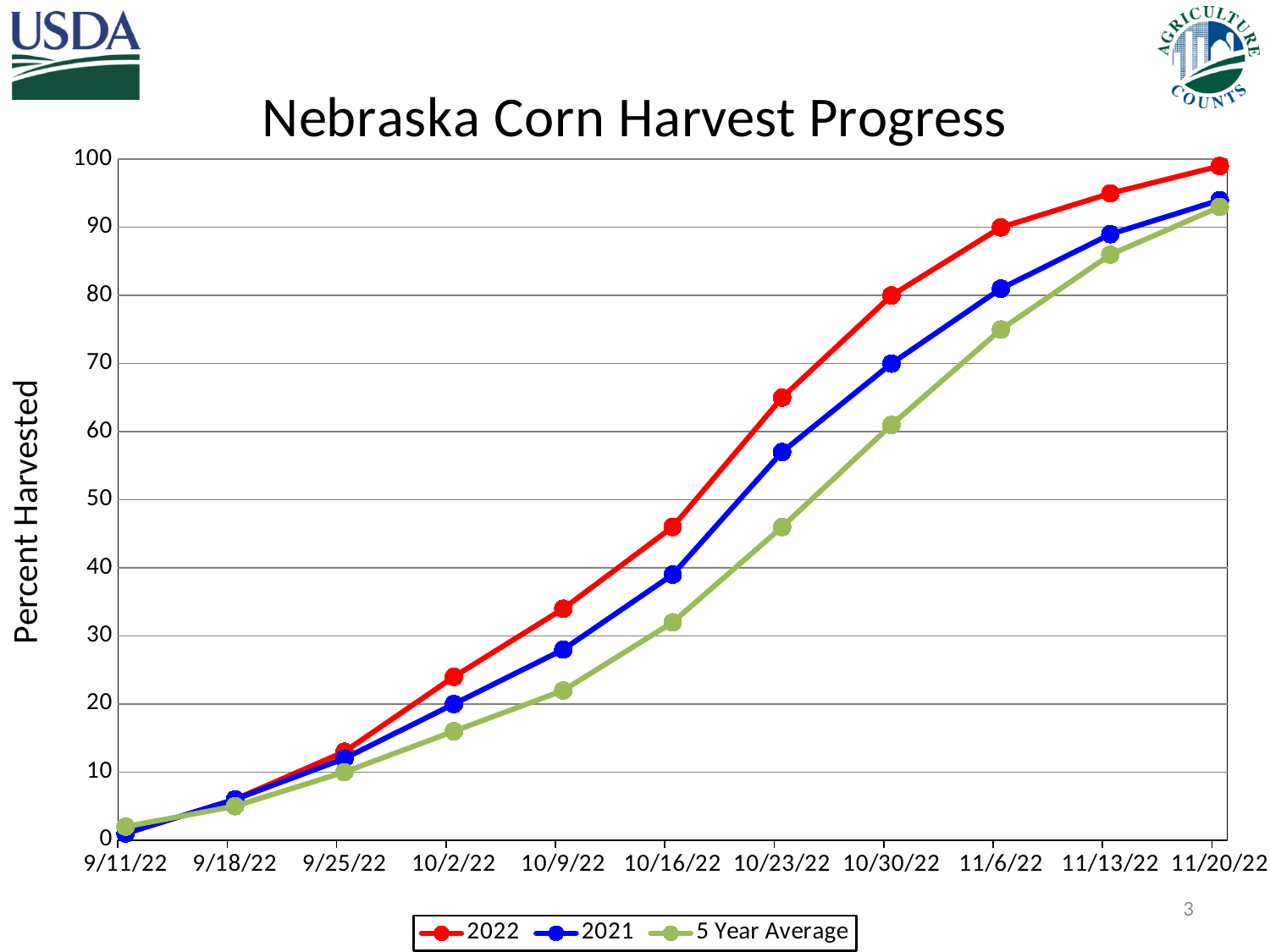
Is the value for 5 Year Average on 10/16/22 greater or less than 40? less On 10/23/22, which is larger: the value for 2022 or the value for 5 Year Average? 2022 How many series does the legend list? 3 Is the value for 2022 on 10/23/22 greater or less than 60? greater Which series has the lowest value on 10/30/22? 5 Year Average What kind of chart is shown on the slide? line chart What is the title of the chart? Nebraska Corn Harvest Progress Do the values for the 2022 series rise or fall from 9/11/22 to 11/20/22? rise Is the value for 2021 on 10/23/22 greater or less than 50? greater Which series has the highest value on 11/20/22? 2022 How many dates are plotted along the x axis? 11 What is the label on the y axis? Percent Harvested